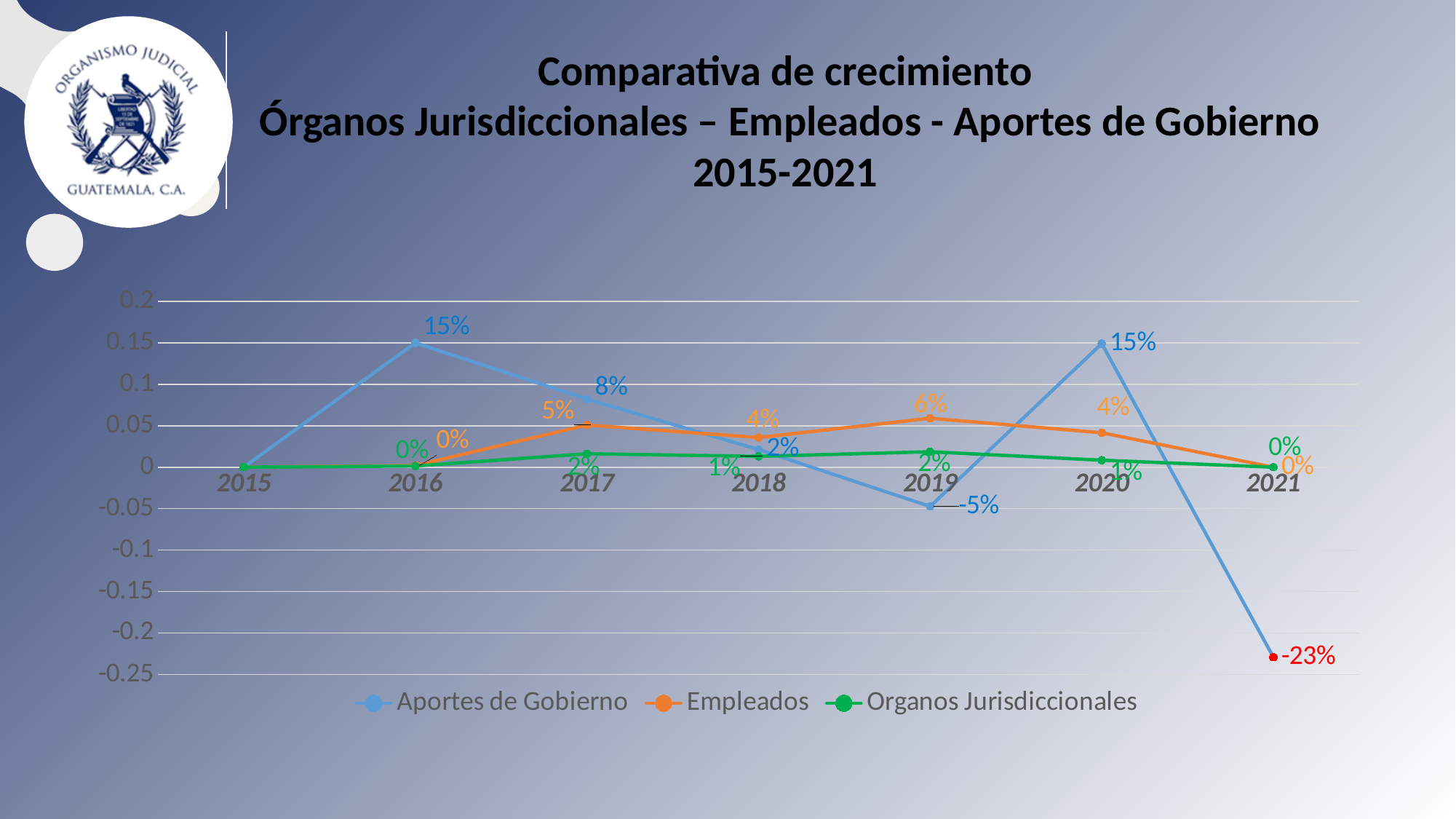
What is the difference between the Empleados values for 2019 and 2020? 2 percentage points How many series does the legend list? 3 What kind of chart is shown on the slide? Line chart What is the difference between the Aportes de Gobierno values for 2020 and 2021? 38 percentage points In 2017, which series has the larger value: Aportes de Gobierno or Empleados? Aportes de Gobierno How many years are shown on the x axis? 7 In which year is the Empleados value highest? 2019 What is the value for Empleados in 2019? 6% In which year is the Aportes de Gobierno value lowest? 2021 What is the value for Organos Jurisdiccionales in 2017? 2% What is the value for Aportes de Gobierno in 2021? -23% What is the value for Aportes de Gobierno in 2019? -5%